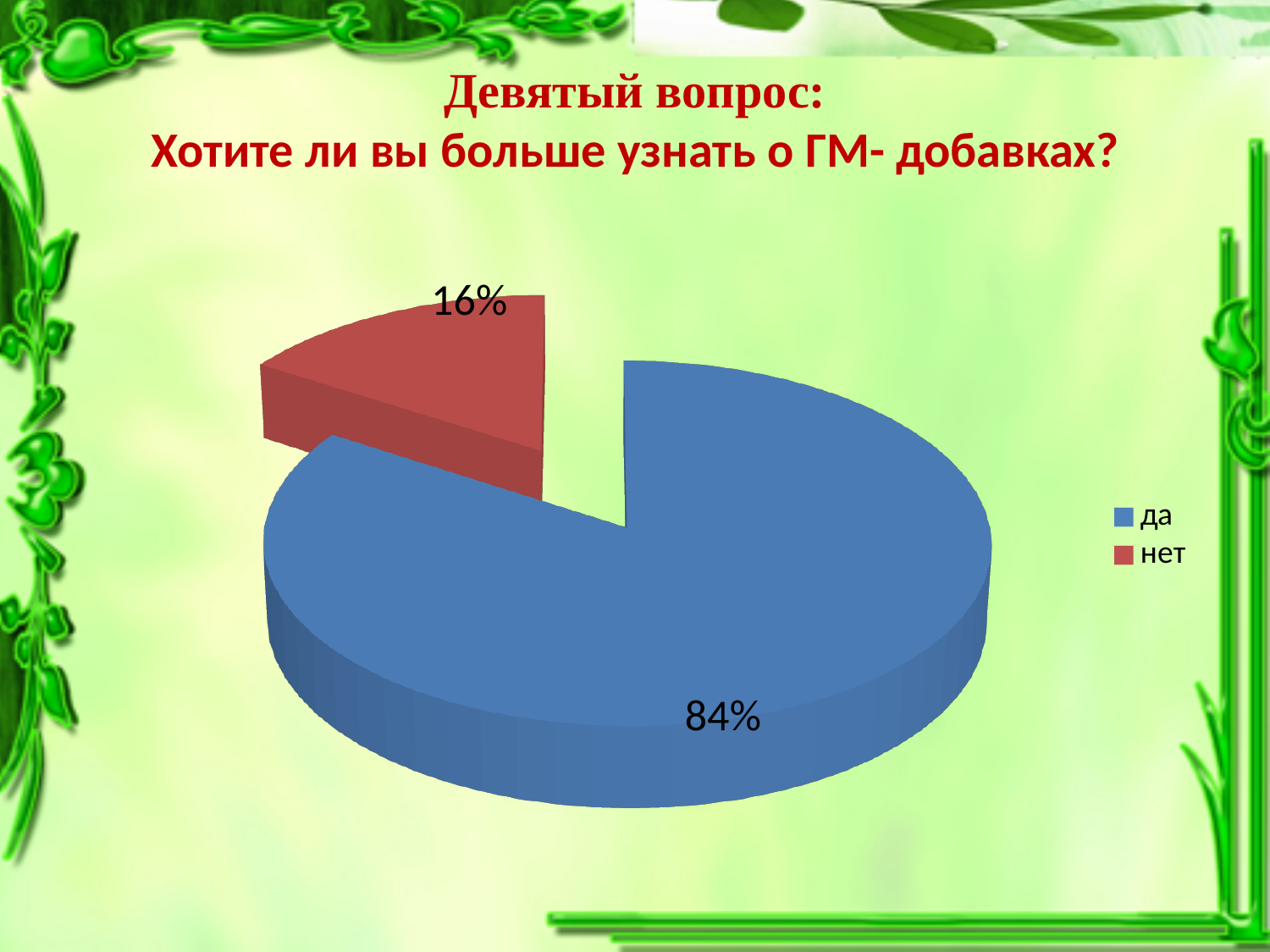
How many entries does the legend list? 2 What share of the pie does "да" have? 84% What is the total of the two slices shown on the pie chart? 100% Which category has the smallest slice of the pie? нет What kind of chart is shown on the slide? pie chart What colour is the slice for "нет"? red Which category has the largest slice of the pie? да Which is larger, the share for "да" or the share for "нет"? да What colour is the slice for "да"? blue How many categories does the pie chart show? 2 What is the difference between the shares for "да" and "нет"? 68% What share of the pie does "нет" have? 16%